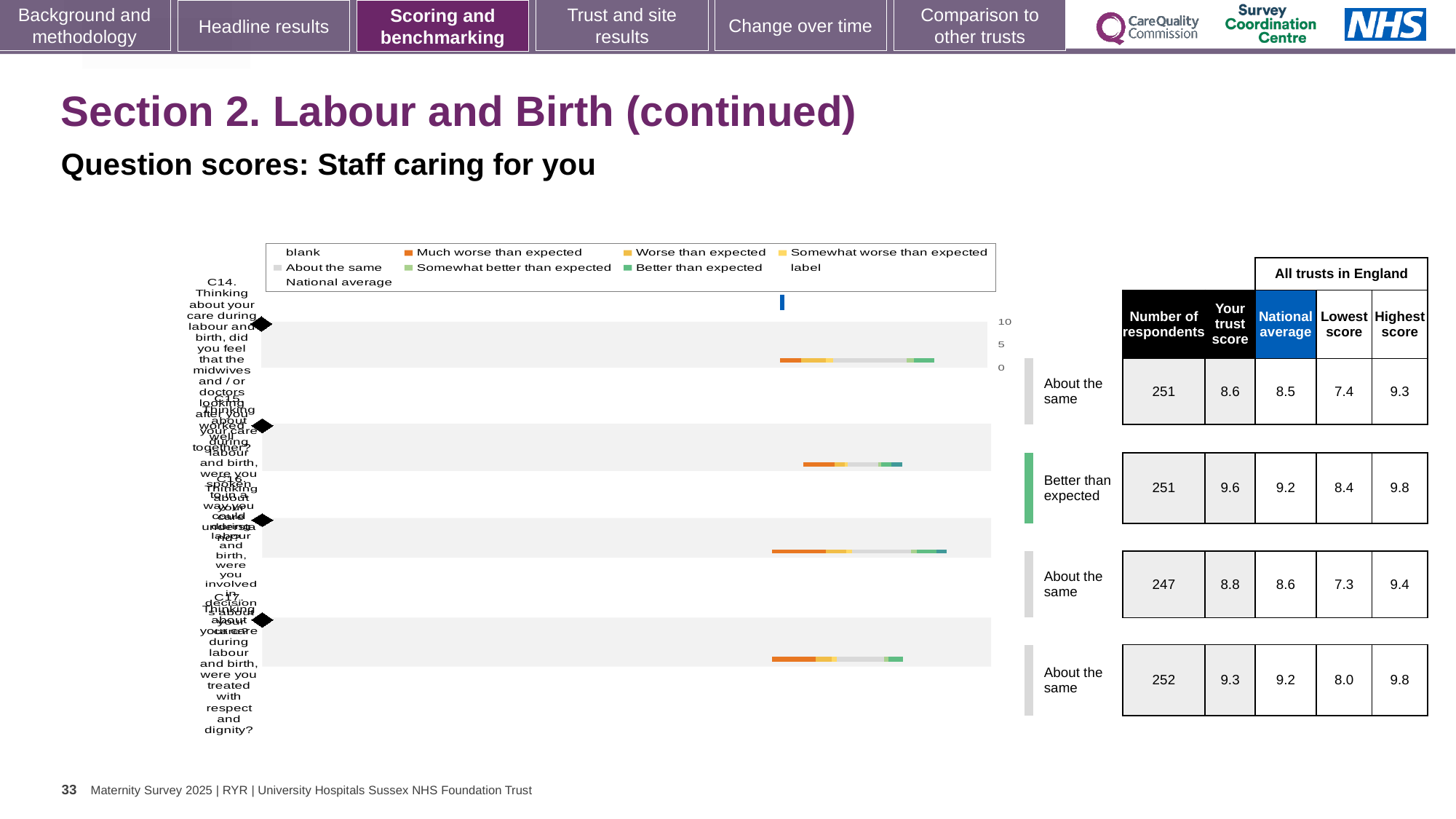
In the table beside the chart, what is the difference between the highest score and the lowest score for the 'Better than expected' row? 1.4 How many question rows (bars) does the chart show? 4 How many of the four rows are labelled 'About the same'? 3 In the table beside the chart, what is the 'Your trust score' for the row labelled 'Better than expected'? 9.6 In the table beside the chart, how many respondents are listed for the row labelled 'Better than expected'? 251 What kind of chart is shown on the slide? bar chart How many entries does the chart legend list? 9 What colour does the legend use for 'Much worse than expected'? orange What is the subtitle above the chart describing the question scores? Question scores: Staff caring for you In the table beside the chart, which row has the highest 'Your trust score'? Better than expected In the table beside the chart, what is the national average for the bottom row (252 respondents)? 9.2 In the table beside the chart, for the 'Better than expected' row, which is larger: the trust score or the national average? the trust score